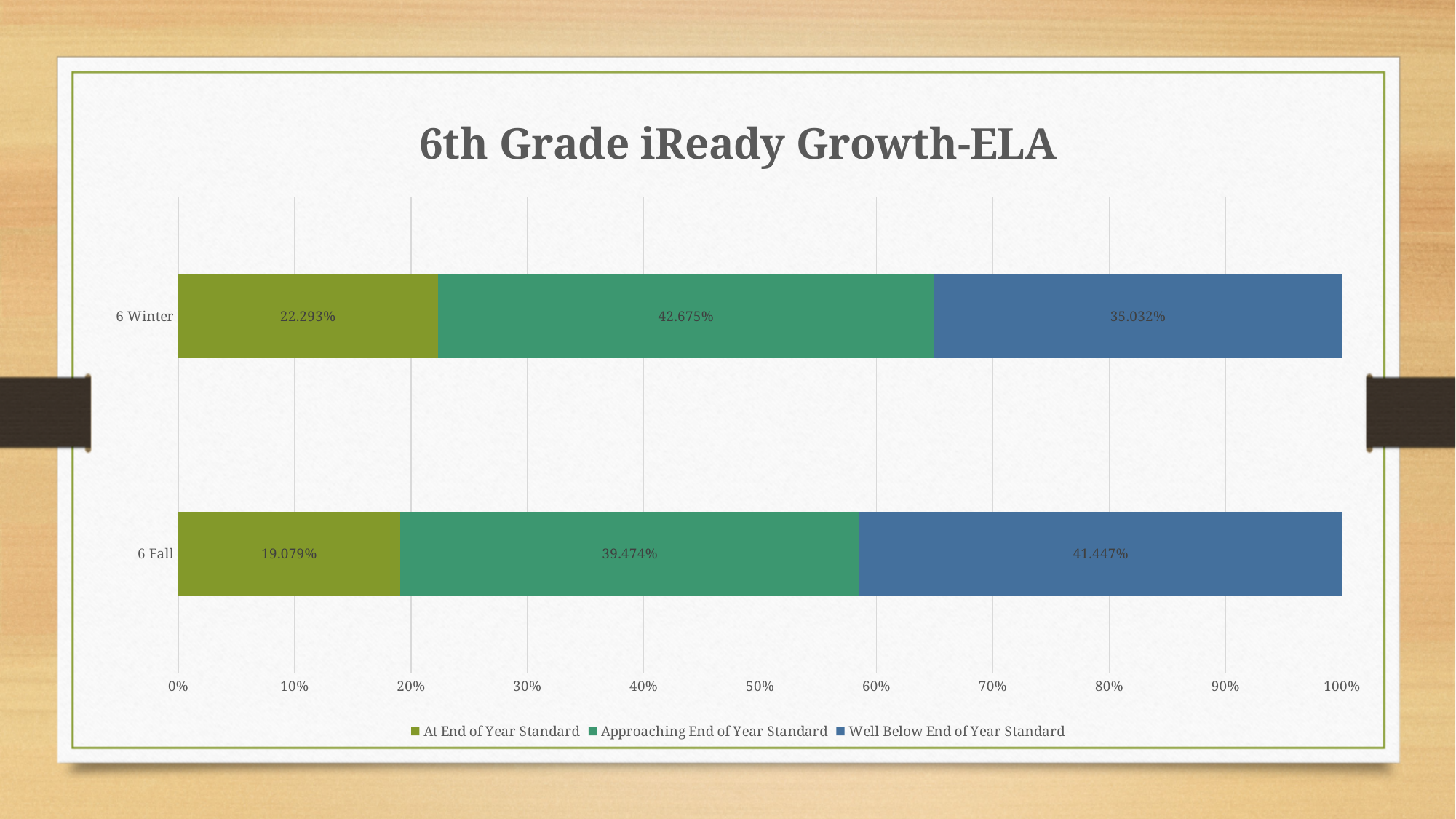
How many series does the legend list? 3 Which series has the largest segment in the 6 Fall bar? Well Below End of Year Standard Which series has the smallest segment in the 6 Winter bar? At End of Year Standard Which is larger: the Approaching End of Year Standard value for 6 Winter or for 6 Fall? 6 Winter What is the value for At End of Year Standard in the 6 Fall bar? 19.079% What is the value for Well Below End of Year Standard in the 6 Fall bar? 41.447% What is the difference between the At End of Year Standard values for 6 Winter and 6 Fall? 3.214% What is the value for At End of Year Standard in the 6 Winter bar? 22.293% How many categories (bars) are shown on the chart? 2 What is the difference between the Well Below End of Year Standard values for 6 Fall and 6 Winter? 6.415% What kind of chart is shown on the slide? Stacked bar chart What is the value for Approaching End of Year Standard in the 6 Winter bar? 42.675%